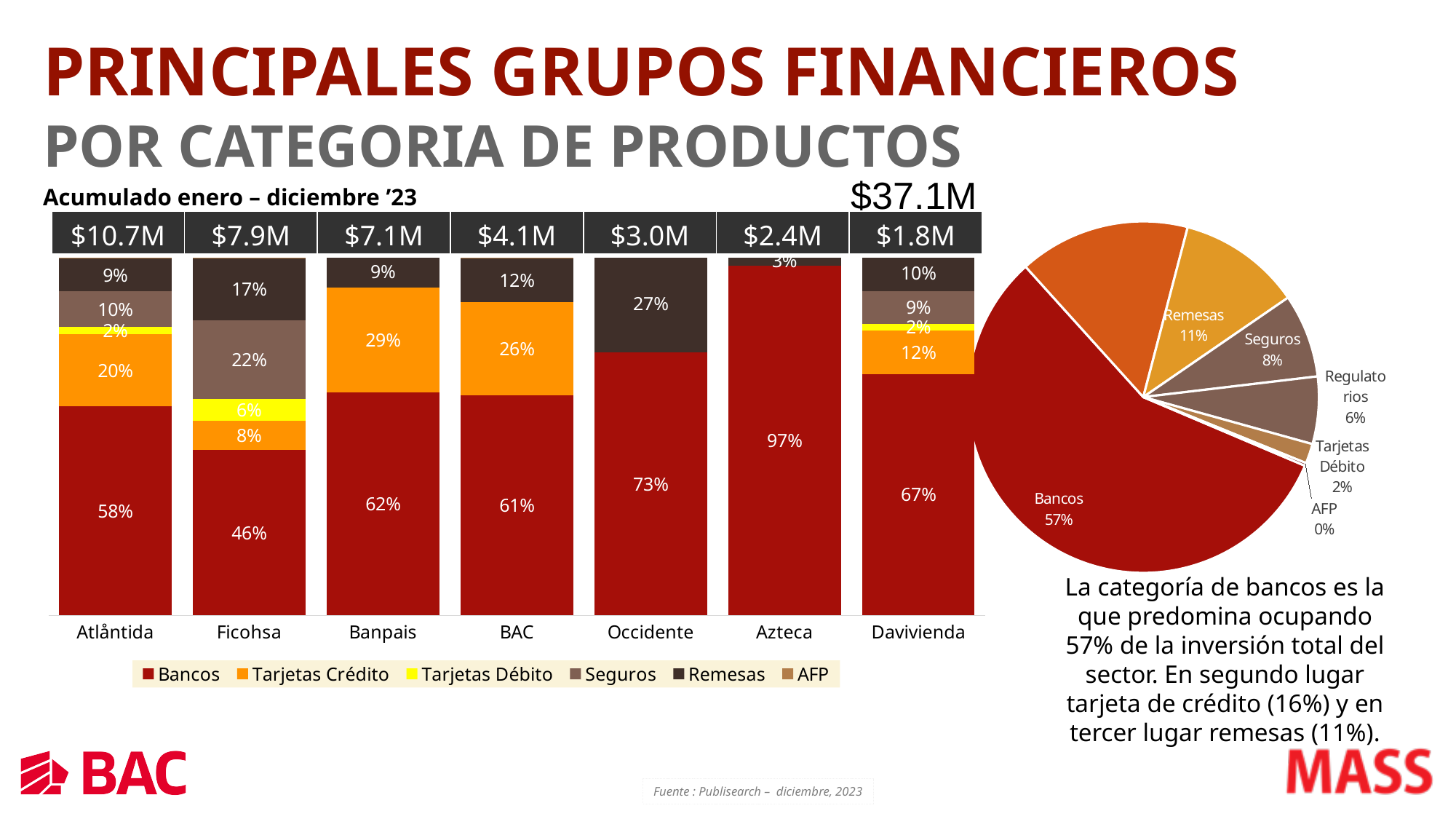
In the stacked bar chart, what is the total amount shown above the Atlántida bar? $10.7M In the stacked bar chart, which financial group has the highest Bancos percentage? Azteca In the pie chart, what share does Bancos have? 57% In the stacked bar chart, which is larger: the Seguros percentage for Ficohsa or for Davivienda? Ficohsa In the pie chart, what share does Seguros have? 8% In the stacked bar chart, what percentage does Tarjetas Crédito represent for Banpais? 29% In the stacked bar chart, which financial group has the lowest Bancos percentage? Ficohsa In the stacked bar chart, what percentage does Bancos represent for Ficohsa? 46% What kind of chart is the one on the left of the slide? Stacked bar chart In the stacked bar chart, what is the difference between the Remesas percentage for Ficohsa and for Atlántida? 8% How many financial groups are shown on the x axis of the stacked bar chart? 7 How many series does the legend of the stacked bar chart list? 6